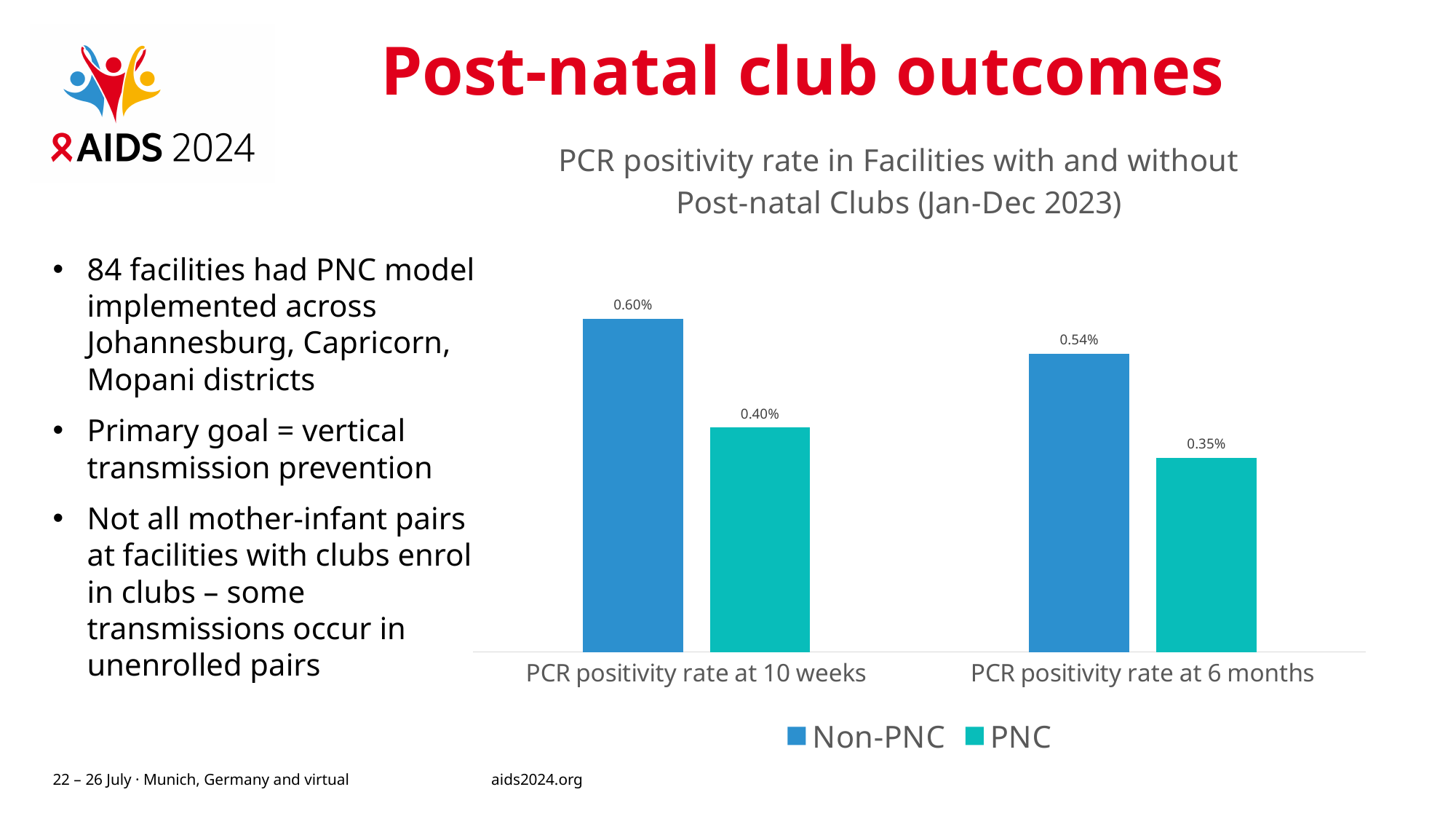
What is the difference between the Non-PNC and PNC PCR positivity rates at 6 months? 0.19% At 6 months, which is larger: the Non-PNC or the PNC PCR positivity rate? Non-PNC Which bar in the chart has the lowest value? PNC, PCR positivity rate at 6 months What is the PCR positivity rate at 6 months for Non-PNC facilities? 0.54% What type of chart is shown on the slide? Bar chart What is the PCR positivity rate at 6 months for PNC facilities? 0.35% How many series does the chart legend list? 2 Which bar in the chart has the highest value? Non-PNC, PCR positivity rate at 10 weeks What is the PCR positivity rate at 10 weeks for Non-PNC facilities? 0.60% How many categories are shown on the x axis of the chart? 2 What is the PCR positivity rate at 10 weeks for PNC facilities? 0.40% What is the difference between the Non-PNC and PNC PCR positivity rates at 10 weeks? 0.20%